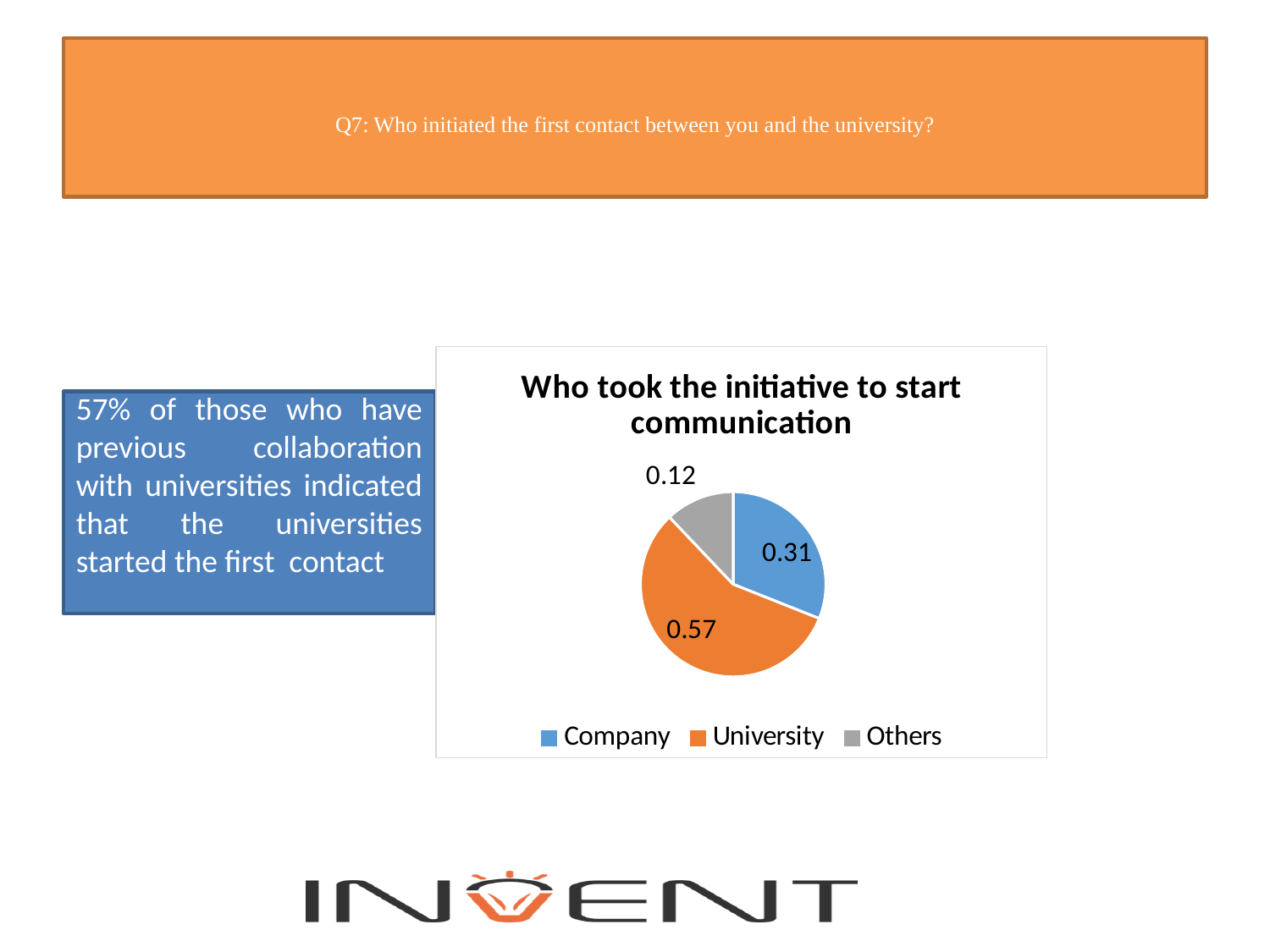
What is the value for Others? 0.12 Which category has the smallest slice? Others What is the value for University? 0.57 What kind of chart is shown on the slide? pie chart How many entries does the legend list? 3 What colour is the University slice? orange How many categories does the pie chart show? 3 What is the value for Company? 0.31 Which is larger, the value for Company or the value for Others? Company Which category has the largest slice? University What is the chart's title? Who took the initiative to start communication What is the difference between the values for University and Company? 0.26